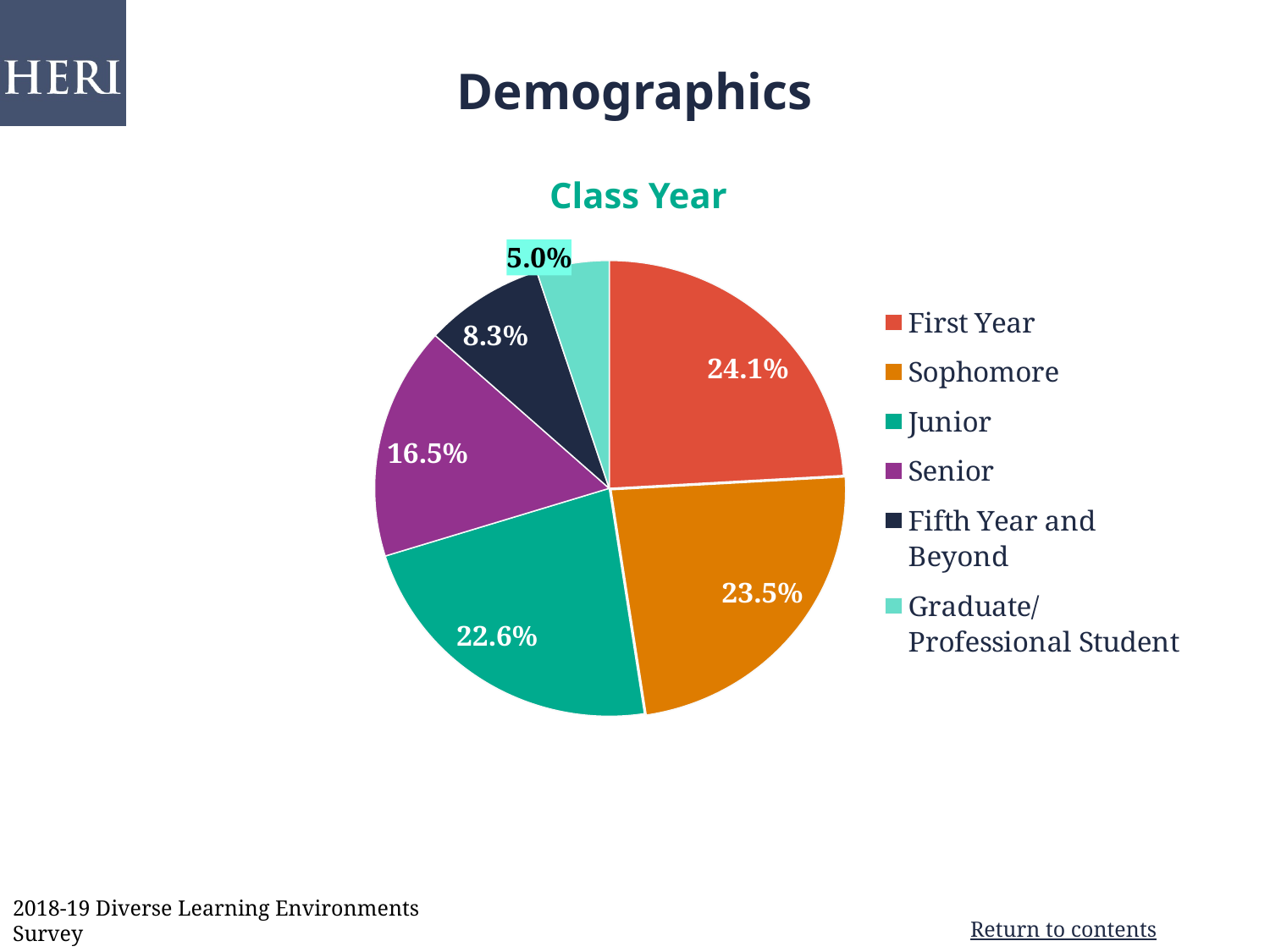
What is the value for Fifth Year and Beyond? 8.3% Which is larger, the Junior slice or the Senior slice? Junior What type of chart is shown on the slide? Pie chart What percentage is labelled for Senior? 16.5% Which category has the smallest slice of the pie? Graduate/Professional Student Which class year has the largest slice of the pie? First Year What is the value shown for Junior? 22.6% What share of the pie is Graduate/Professional Student? 5.0% What is the difference in percentage points between Senior and Fifth Year and Beyond? 8.2 What share of the pie does Sophomore represent? 23.5% What percentage of the Class Year pie chart is First Year? 24.1% How many categories are shown in the pie chart? 6